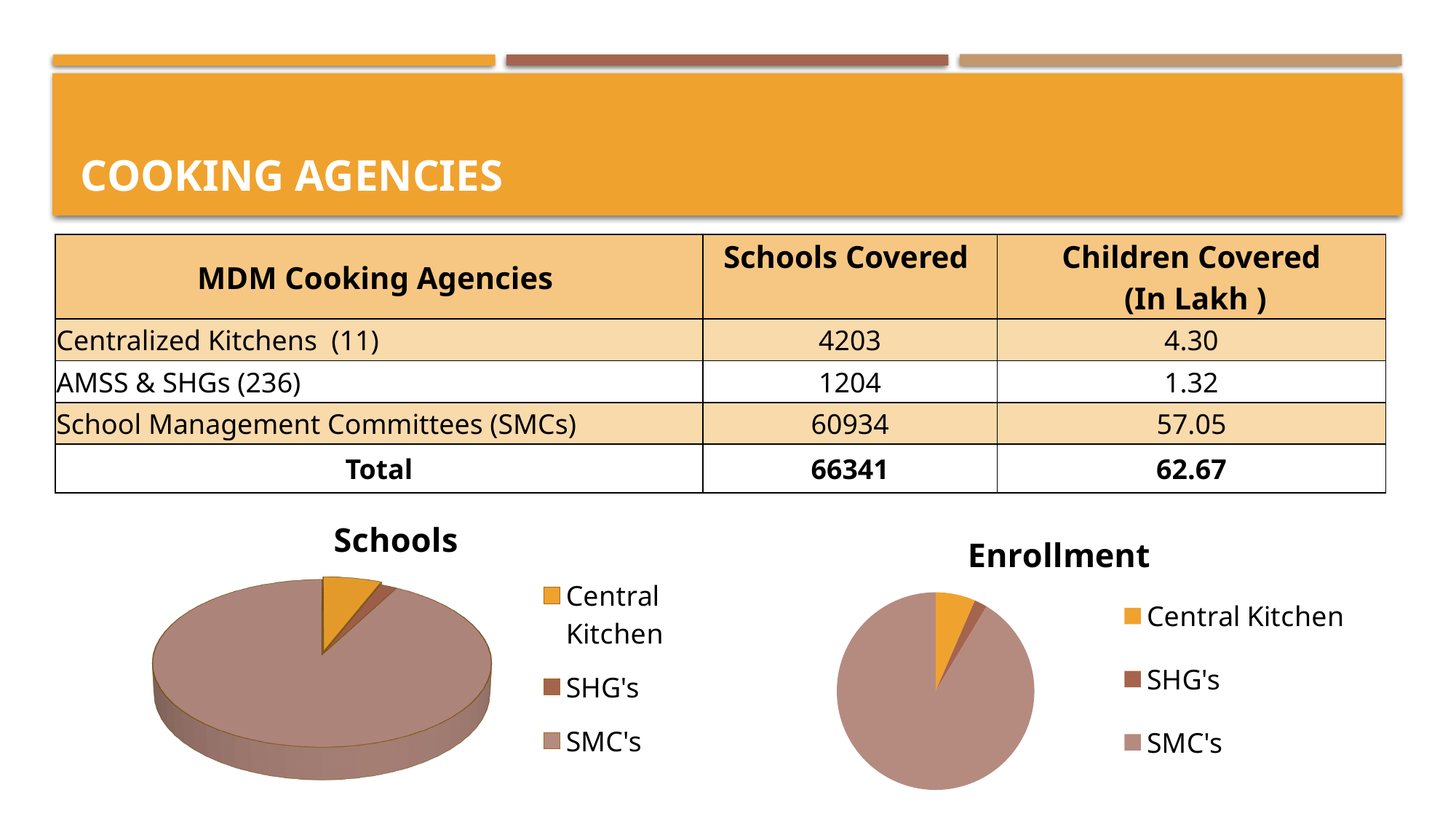
What kind of chart is the "Schools" chart? Pie chart How many categories does the legend of the "Enrollment" pie chart list? 3 In the "Enrollment" pie chart, which slice is larger: SMC's or Central Kitchen? SMC's In the "Schools" pie chart, which category has the largest slice? SMC's In the "Enrollment" pie chart, which category has the smallest slice? SHG's What is the title of the pie chart on the left of the slide? Schools In the "Enrollment" pie chart, which category has the largest slice? SMC's In the "Schools" pie chart, which slice is larger: Central Kitchen or SHG's? Central Kitchen How many categories does the legend of the "Schools" pie chart list? 3 What colour is the SMC's slice in the "Enrollment" pie chart? Brownish pink What kind of chart is the "Enrollment" chart? Pie chart In the "Schools" pie chart, which category has the smallest slice? SHG's